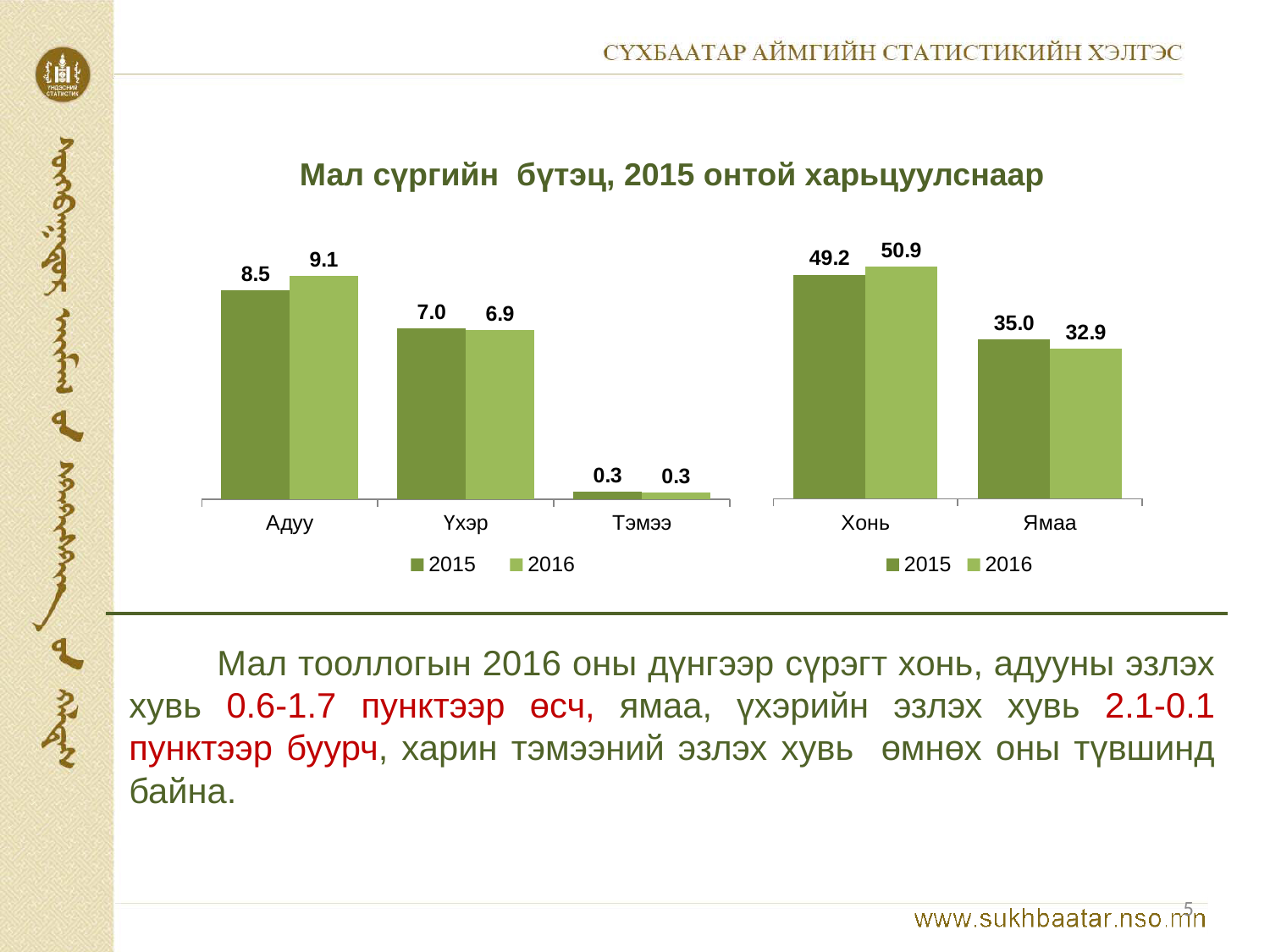
How many series does the legend of the right chart list? 2 What type of chart is the left chart? bar chart In the left chart, what is the 2015 value for Үхэр? 7.0 In the right chart, what is the 2016 value for Хонь? 50.9 In the right chart, which category has the highest 2016 value? Хонь How many categories are shown in the left chart? 3 In the left chart, what is the difference between the 2016 and 2015 values for Адуу? 0.6 In the right chart, what is the difference between the 2015 and 2016 values for Ямаа? 2.1 In the right chart, is the 2016 value for Хонь larger or smaller than its 2015 value? larger In the left chart, which category has the lowest 2015 value? Тэмээ In the left chart, what is the 2016 value for Адуу? 9.1 In the right chart, what is the 2015 value for Ямаа? 35.0